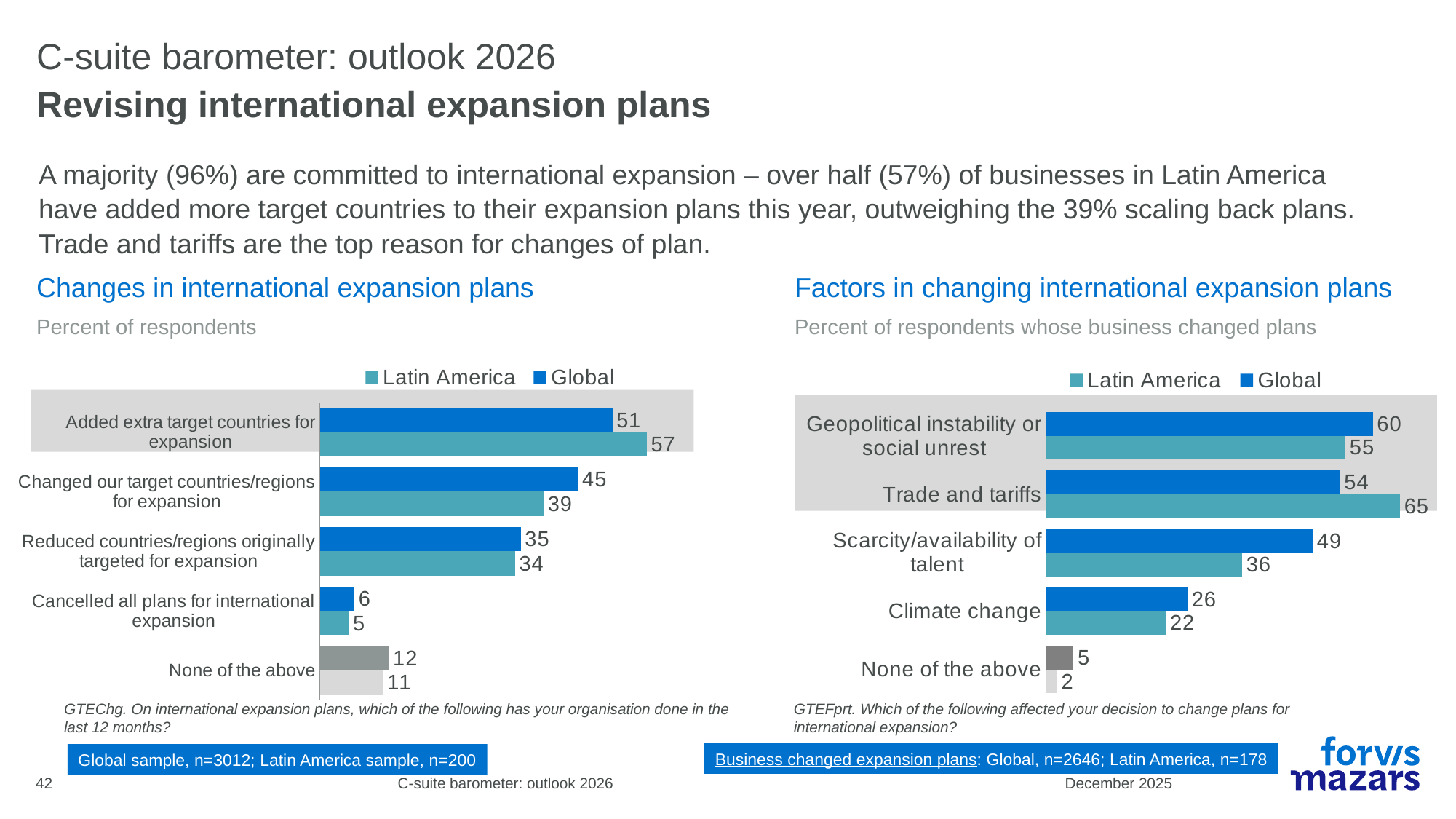
What type of chart is the 'Changes in international expansion plans' chart? Bar chart In the 'Changes in international expansion plans' chart, which category has the lowest Latin America value? Cancelled all plans for international expansion In the 'Changes in international expansion plans' chart, what is the Latin America value for 'Added extra target countries for expansion'? 57 In the 'Changes in international expansion plans' chart, how many categories are shown? 5 In the 'Factors in changing international expansion plans' chart, which is larger for 'Climate change': the Global value or the Latin America value? Global In the 'Factors in changing international expansion plans' chart, what is the Global value for 'Scarcity/availability of talent'? 49 How many series does the legend of the 'Factors in changing international expansion plans' chart list? 2 In the 'Factors in changing international expansion plans' chart, what is the Latin America value for 'Trade and tariffs'? 65 In the 'Changes in international expansion plans' chart, what is the difference between the Latin America and Global values for 'Added extra target countries for expansion'? 6 In the 'Factors in changing international expansion plans' chart, which category has the highest Global value? Geopolitical instability or social unrest In the 'Factors in changing international expansion plans' chart, what is the difference between the Global and Latin America values for 'Scarcity/availability of talent'? 13 In the 'Changes in international expansion plans' chart, what is the Global value for 'Changed our target countries/regions for expansion'? 45